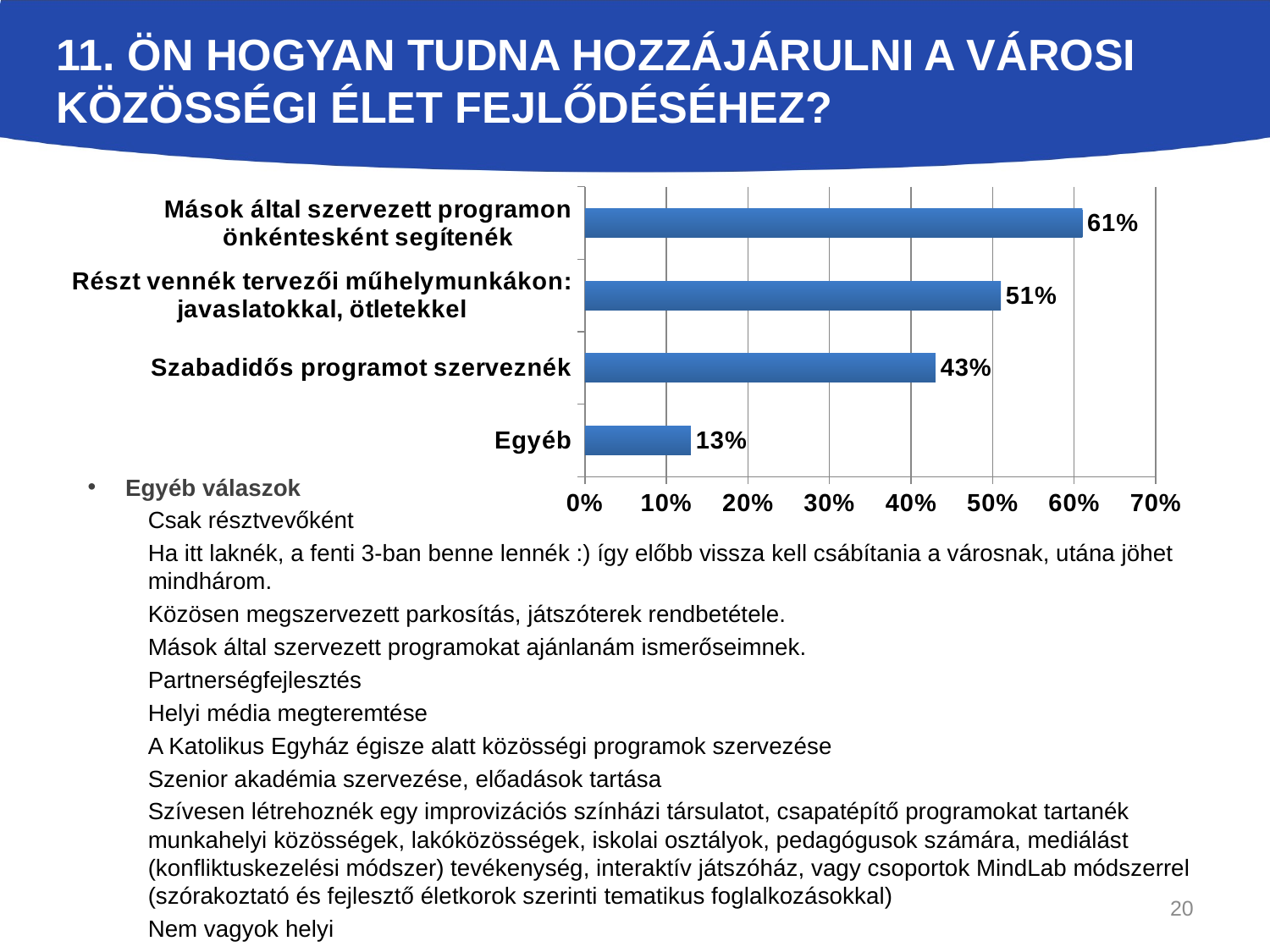
How many categories are shown in the chart? 4 What is the value for "Szabadidős programot szerveznék"? 43% Which category has the lowest value? Egyéb What is the difference between the values for "Részt vennék tervezői műhelymunkákon: javaslatokkal, ötletekkel" and "Egyéb"? 38% What is the maximum value shown on the x axis of the chart? 70% Which is larger: the value for "Részt vennék tervezői műhelymunkákon: javaslatokkal, ötletekkel" or for "Szabadidős programot szerveznék"? Részt vennék tervezői műhelymunkákon: javaslatokkal, ötletekkel What is the value for "Mások által szervezett programon önkéntesként segítenék"? 61% What is the value for "Részt vennék tervezői műhelymunkákon: javaslatokkal, ötletekkel"? 51% What kind of chart is shown on the slide? Bar chart What is the value for "Egyéb"? 13% Which category has the highest value? Mások által szervezett programon önkéntesként segítenék What is the difference between the values for "Mások által szervezett programon önkéntesként segítenék" and "Szabadidős programot szerveznék"? 18%